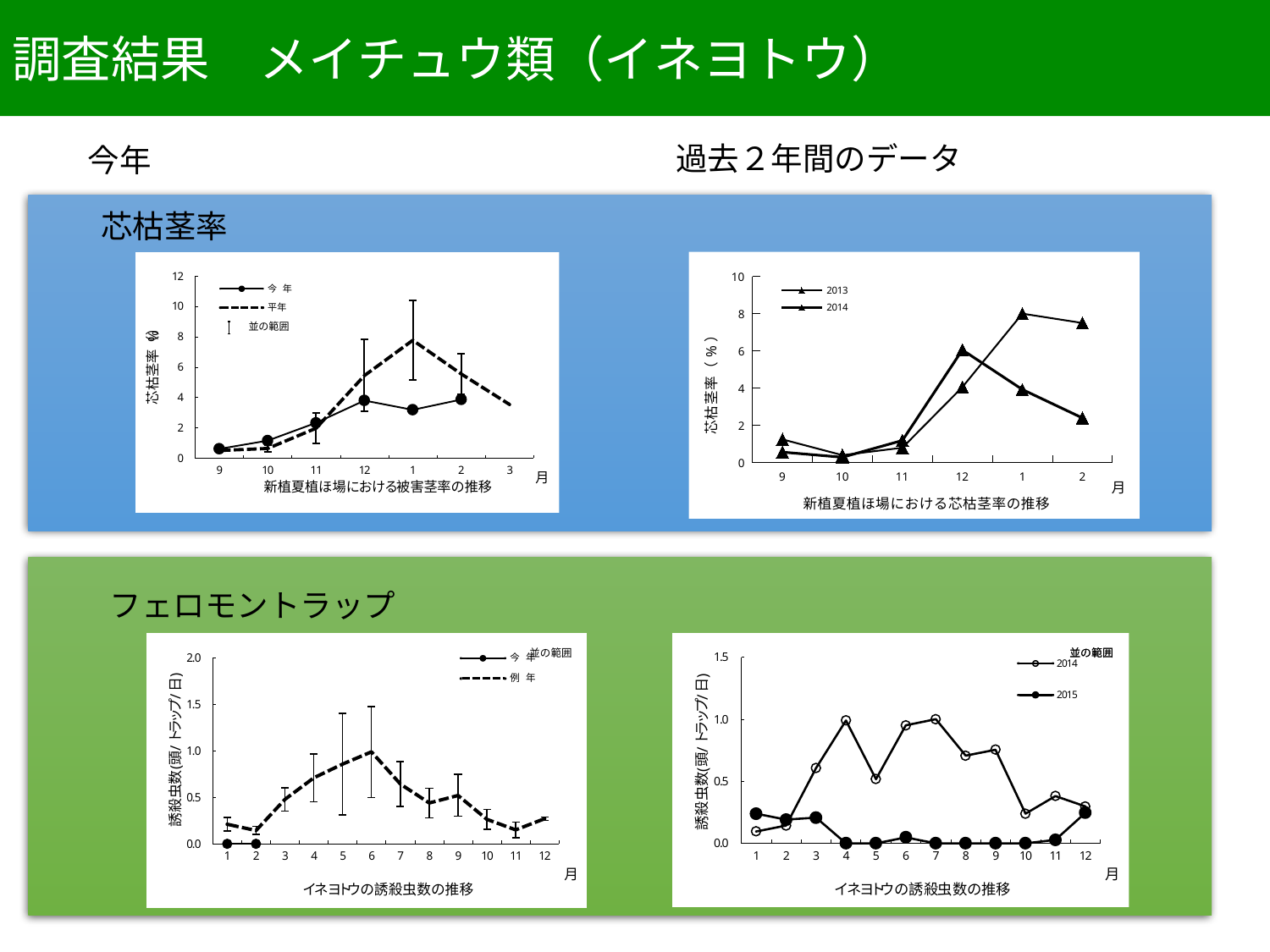
In the bottom-right chart (イネヨトウの誘殺虫数の推移, right), how many months are plotted on the x axis? 12 In the top-left chart (新植夏植ほ場における被害茎率の推移), how many entries does the legend list? 3 In the bottom-left chart (イネヨトウの誘殺虫数の推移, left), is the 今年 value for month 1 greater or less than 0.5? less In the top-right chart (新植夏植ほ場における芯枯茎率の推移), at which month does the highest plotted value occur? 1 In the bottom-right chart (イネヨトウの誘殺虫数の推移, right), which is larger at month 7, the 2014 value or the 2015 value? 2014 In the top-left chart (新植夏植ほ場における被害茎率の推移), which is larger at month 1, the 今年 value or the 平年 value? 平年 In the top-left chart (新植夏植ほ場における被害茎率の推移), is the 今年 value for month 9 greater or less than 2? less What kind of chart is the top-left chart titled 新植夏植ほ場における被害茎率の推移? line chart In the top-right chart (新植夏植ほ場における芯枯茎率の推移), how many series does the legend list? 2 In the top-left chart (新植夏植ほ場における被害茎率の推移), does the 今年 line rise or fall from month 9 to month 12? rise In the bottom-left chart (イネヨトウの誘殺虫数の推移, left), at which month does the 例年 line reach its highest value? 6 In the top-right chart (新植夏植ほ場における芯枯茎率の推移), is the highest plotted value greater or less than 6? greater